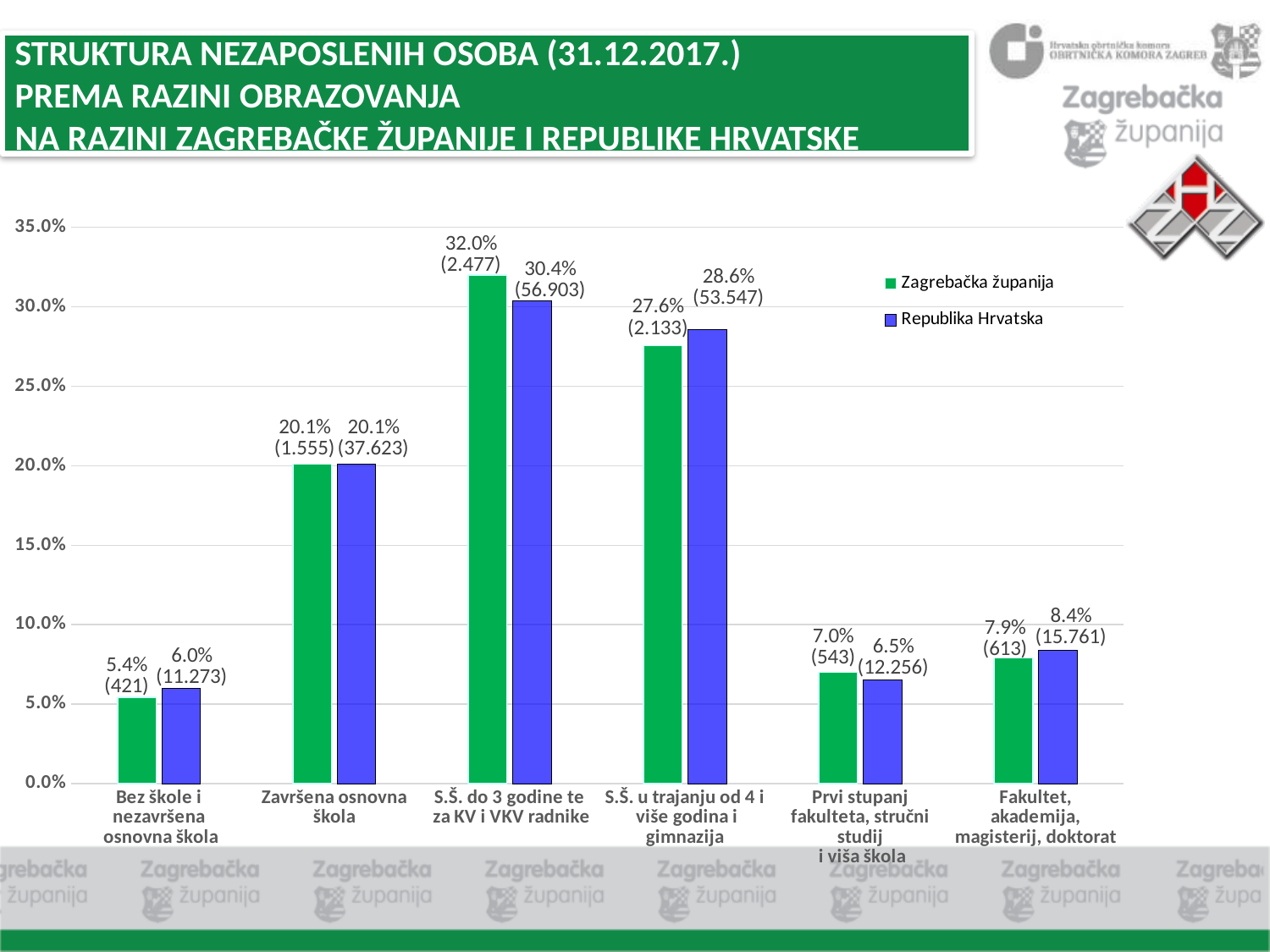
Which category has the lowest value for Zagrebačka županija? Bez škole i nezavršena osnovna škola How many categories are shown on the x axis? 6 In the category 'Prvi stupanj fakulteta, stručni studij i viša škola', which series has the larger value, Zagrebačka županija or Republika Hrvatska? Zagrebačka županija How many series does the legend list? 2 What is the difference between the Zagrebačka županija and Republika Hrvatska values in the category 'S.Š. u trajanju od 4 i više godina i gimnazija'? 1.0% Which category has the highest value for Republika Hrvatska? S.Š. do 3 godine te za KV i VKV radnike What is the value for Zagrebačka županija in the category 'S.Š. do 3 godine te za KV i VKV radnike'? 32.0% Which colour represents Republika Hrvatska in the chart? blue What is the value for Republika Hrvatska in the category 'Fakultet, akademija, magisterij, doktorat'? 8.4% What kind of chart is shown on the slide? bar chart Is the value for Republika Hrvatska in the category 'Završena osnovna škola' greater or less than 25.0%? less What is the value for Zagrebačka županija in the category 'Bez škole i nezavršena osnovna škola'? 5.4%